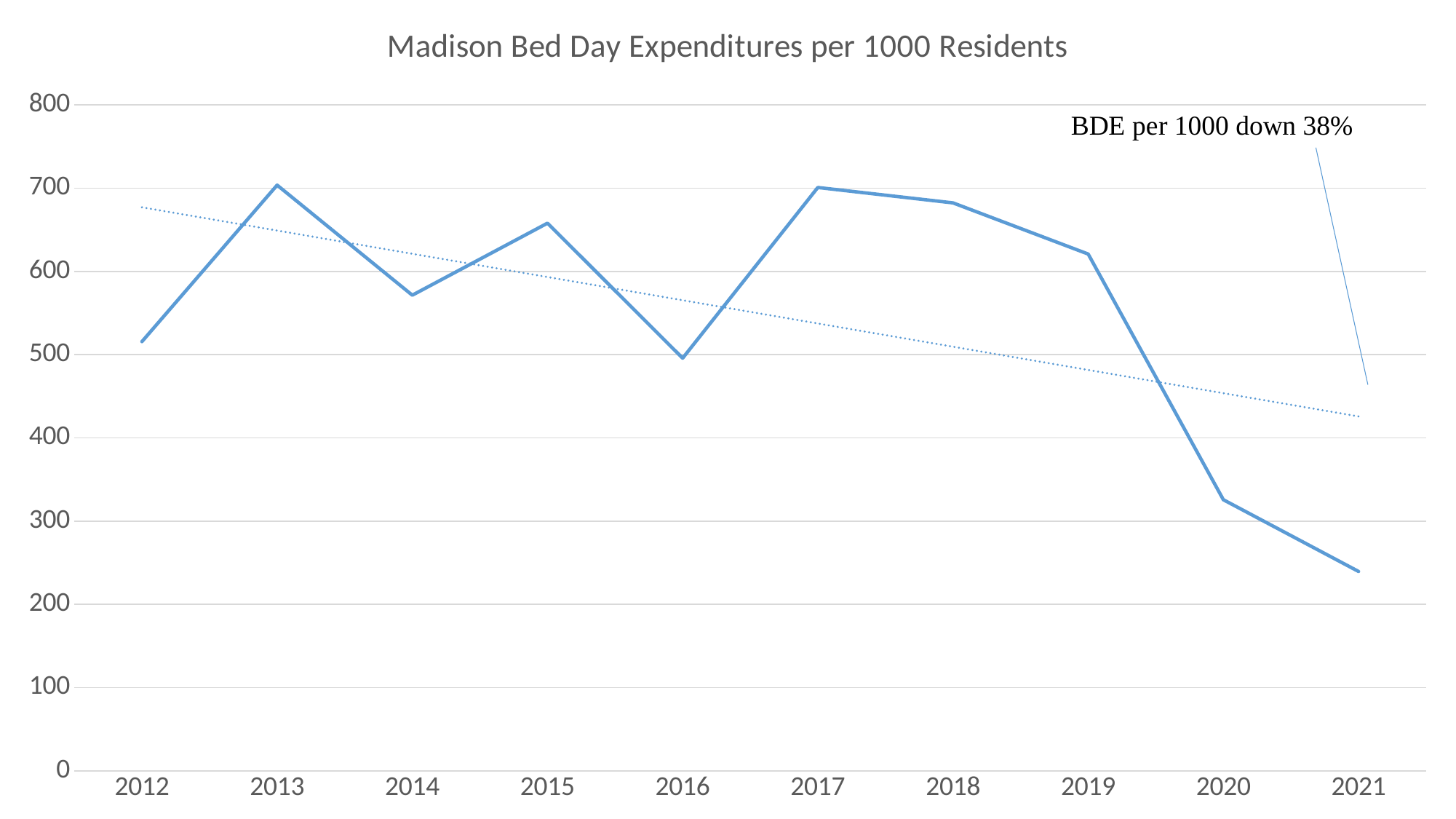
Is the value for 2019 greater or less than 600? greater Which is larger, the value for 2019 or the value for 2020? 2019 Is the value for 2014 greater or less than 600? less Which is larger, the value for 2013 or the value for 2014? 2013 What is the title of the chart? Madison Bed Day Expenditures per 1000 Residents Which year has the lowest value? 2021 Is the value for 2021 greater or less than 300? less How many years are plotted along the x axis? 10 What kind of chart is shown on the slide? line chart What does the text annotation on the chart say? BDE per 1000 down 38%